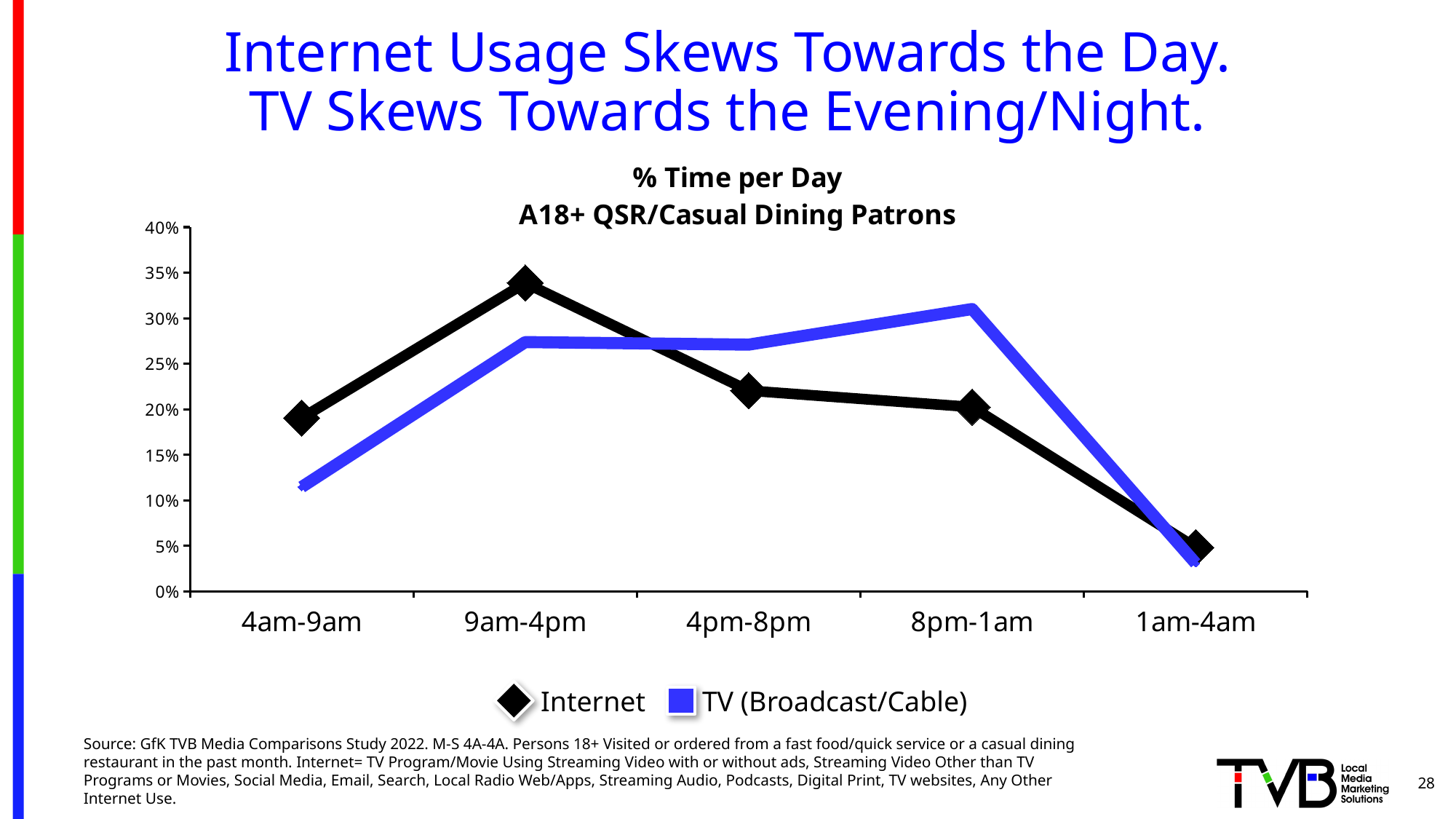
How many series does the legend list? 2 How many time periods are shown on the x axis? 5 In which time period does the TV (Broadcast/Cable) series reach its highest value? 8pm-1am In which time period is the Internet series at its lowest? 1am-4am Does the Internet series rise or fall from 9am-4pm through to 1am-4am? fall In which time period does the Internet series reach its highest value? 9am-4pm Is the TV (Broadcast/Cable) value for 4am-9am greater or less than 15%? less What kind of chart is shown on the slide? line chart What is the title of the chart? % Time per Day A18+ QSR/Casual Dining Patrons Which series has the larger value for 8pm-1am, Internet or TV (Broadcast/Cable)? TV (Broadcast/Cable) Is the Internet value for 9am-4pm greater or less than 30%? greater Which series has the larger value for 4am-9am, Internet or TV (Broadcast/Cable)? Internet